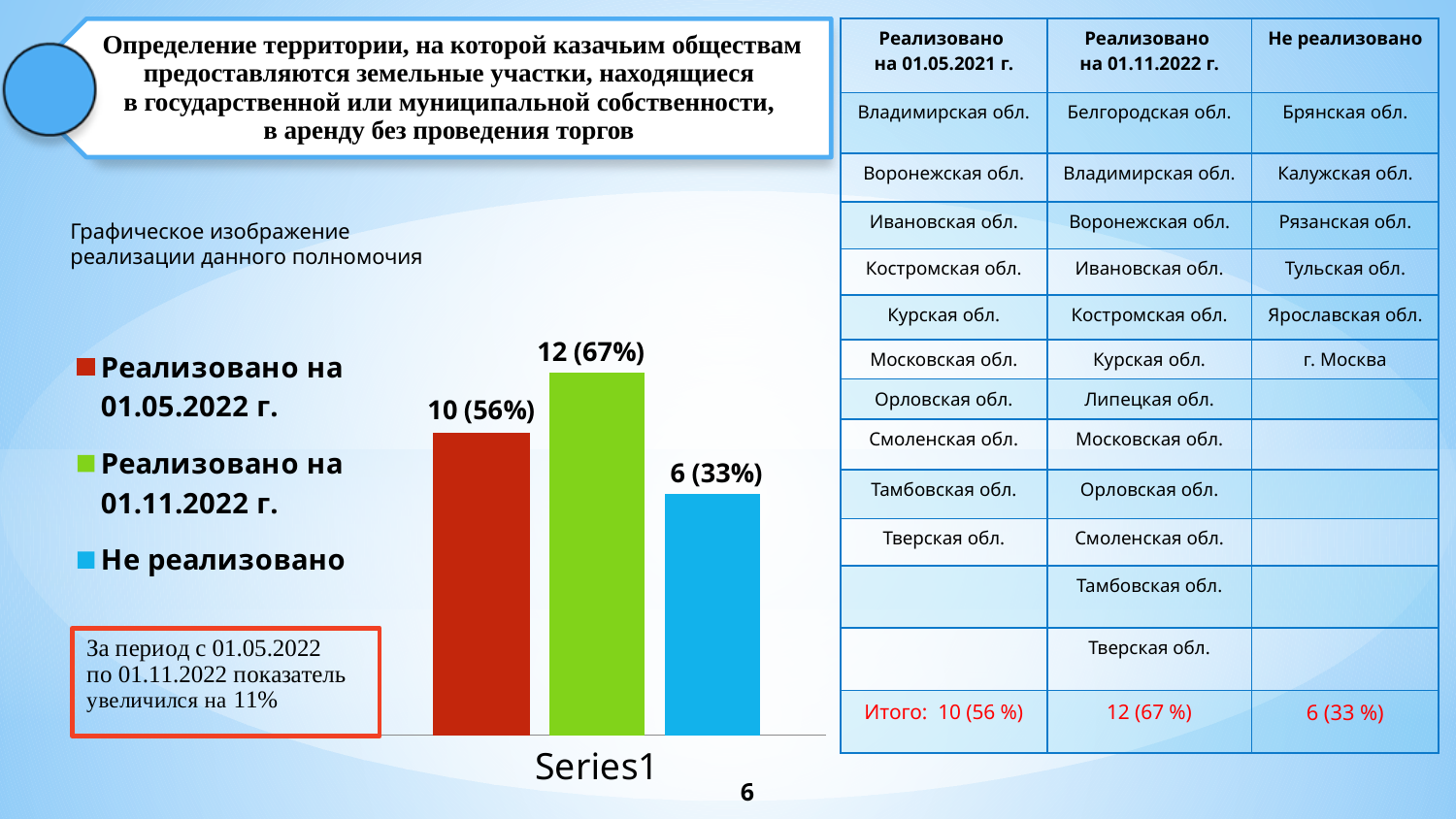
What colour is the bar for "Не реализовано" in the chart? blue Which legend entry has the shortest bar in the chart? Не реализовано Which is larger: the bar for "Реализовано на 01.05.2022 г." or the bar for "Не реализовано"? Реализовано на 01.05.2022 г. Which legend entry has the tallest bar in the chart? Реализовано на 01.11.2022 г. How many bars are plotted in the chart? 3 What kind of chart is shown on the slide? bar chart What value is shown on the data label for the blue bar "Не реализовано"? 6 (33%) How many series does the chart legend list? 3 By how many units does the bar for "Реализовано на 01.11.2022 г." exceed the bar for "Реализовано на 01.05.2022 г."? 2 What value is shown on the data label for the red bar "Реализовано на 01.05.2022 г."? 10 (56%) By how many units does the bar for "Реализовано на 01.05.2022 г." exceed the bar for "Не реализовано"? 4 What value is shown on the data label for the green bar "Реализовано на 01.11.2022 г."? 12 (67%)